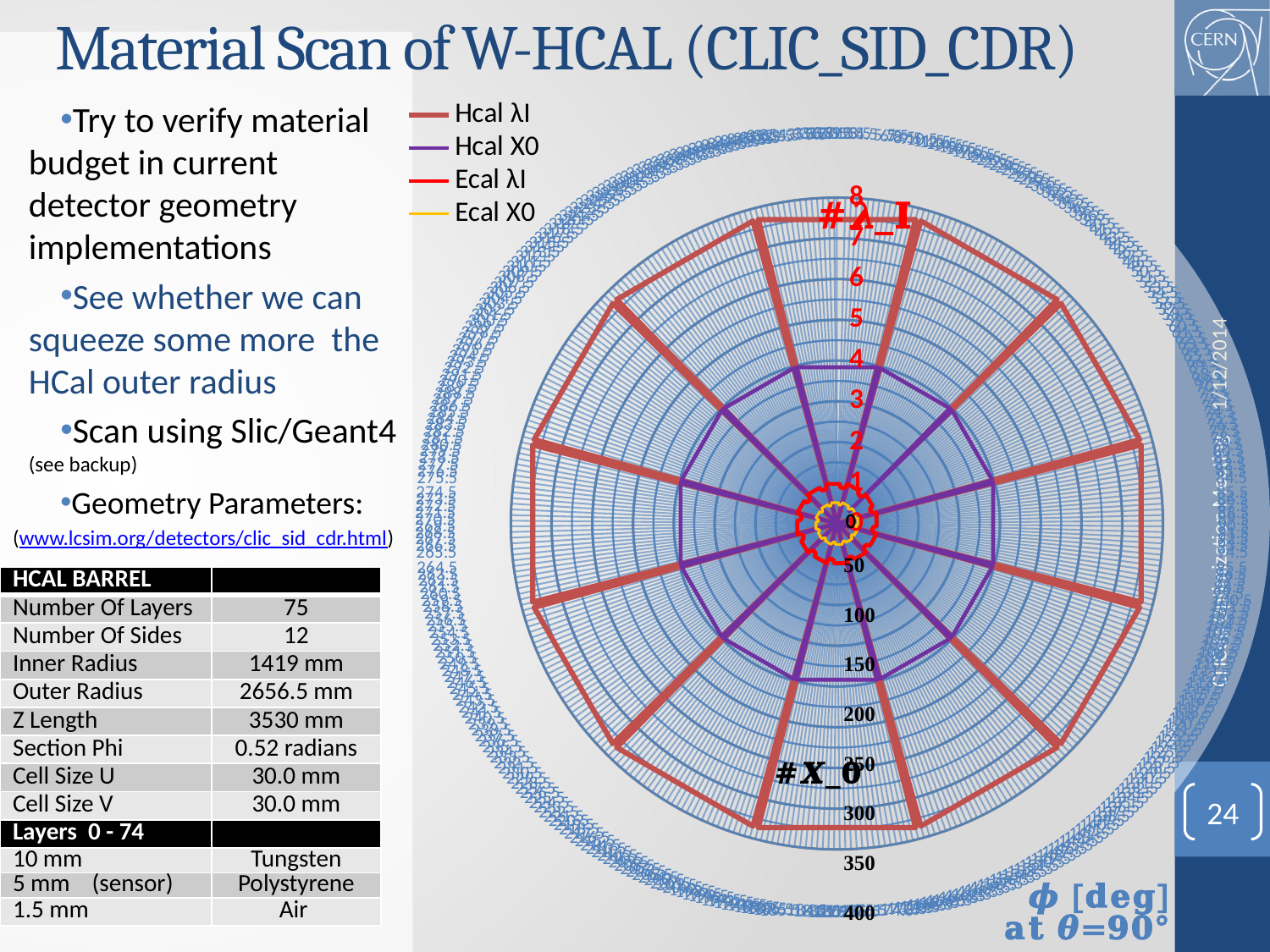
How many series does the chart legend list? 4 Which is larger at the top of the chart (φ = 0°): Hcal λI or Ecal λI? Hcal λI What colour is the Hcal X0 series drawn in? purple Which series is drawn with the innermost (smallest) polygon on the chart? Ecal X0 Is the Ecal X0 value greater or less than 50 on the X0 axis? less Is the Ecal λI value greater or less than 2 on the λI axis? less What is the highest tick value shown on the X0 axis of the chart? 400 What kind of chart is shown on the slide? radar chart Which series is drawn with the outermost polygon on the chart? Hcal λI Is the Hcal λI value at the top of the chart greater or less than 6 on the λI axis? greater